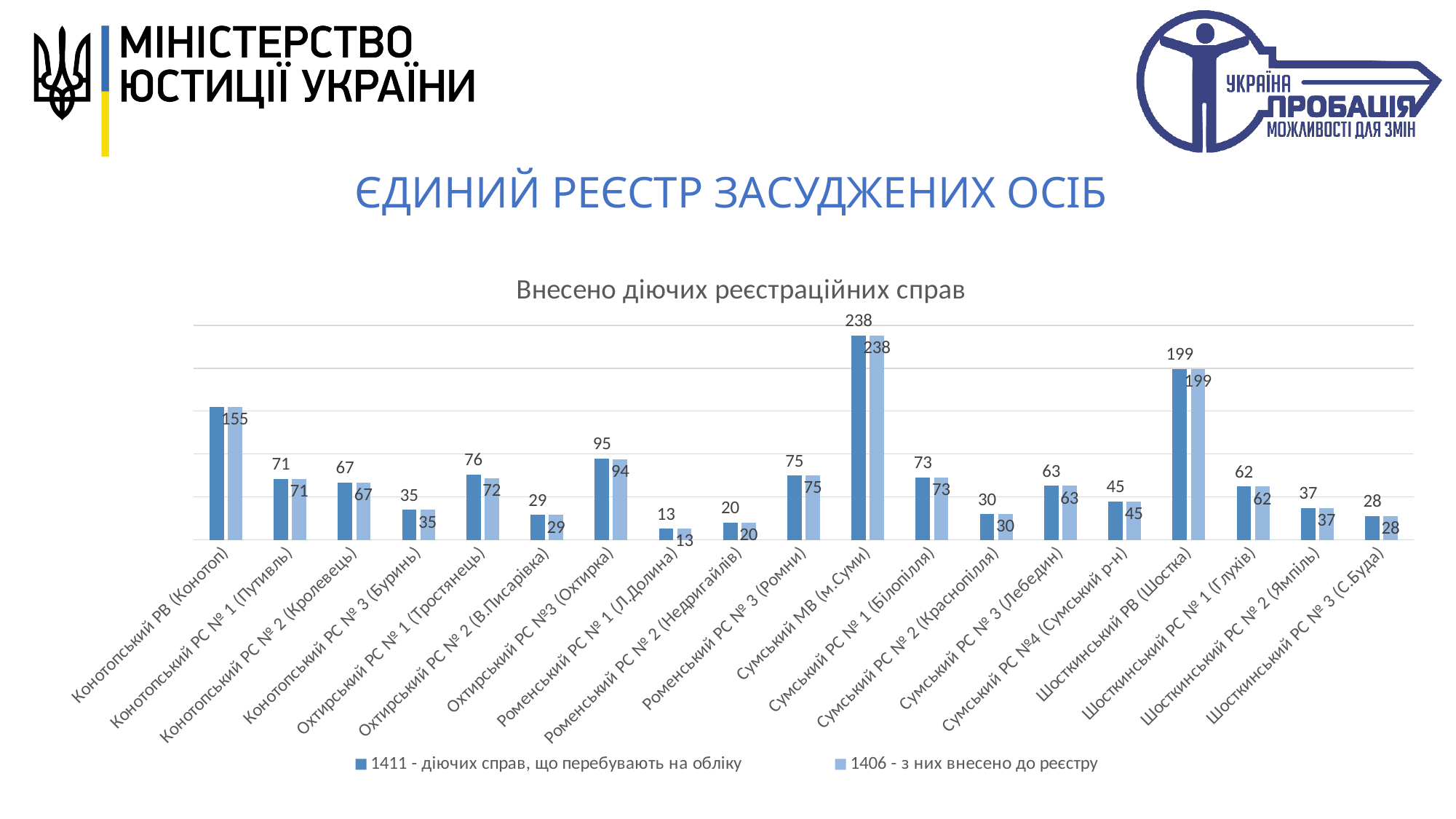
What is the value for Охтирський РС № 1 (Тростянець) in the series "1406 - з них внесено до реєстру"? 72 What is the difference between the two series values for Охтирський РС № 1 (Тростянець)? 4 What is the value for Охтирський РС №3 (Охтирка) in the series "1411 - діючих справ, що перебувають на обліку"? 95 Which category has the lowest value in the series "1406 - з них внесено до реєстру"? Роменський РС № 1 (Л.Долина) How many categories are shown on the x axis of the chart? 19 What is the difference between the "1411 - діючих справ, що перебувають на обліку" values for Сумський МВ (м.Суми) and Шосткинський РВ (Шостка)? 39 What is the title of the chart? Внесено діючих реєстраційних справ Which is larger in the series "1411 - діючих справ, що перебувають на обліку": Конотопський РВ (Конотоп) or Шосткинський РВ (Шостка)? Шосткинський РВ (Шостка) Which category has the highest value in the series "1411 - діючих справ, що перебувають на обліку"? Сумський МВ (м.Суми) How many series does the legend list? 2 What is the value for Сумський МВ (м.Суми) in the series "1411 - діючих справ, що перебувають на обліку"? 238 What kind of chart is shown on the slide? Bar chart